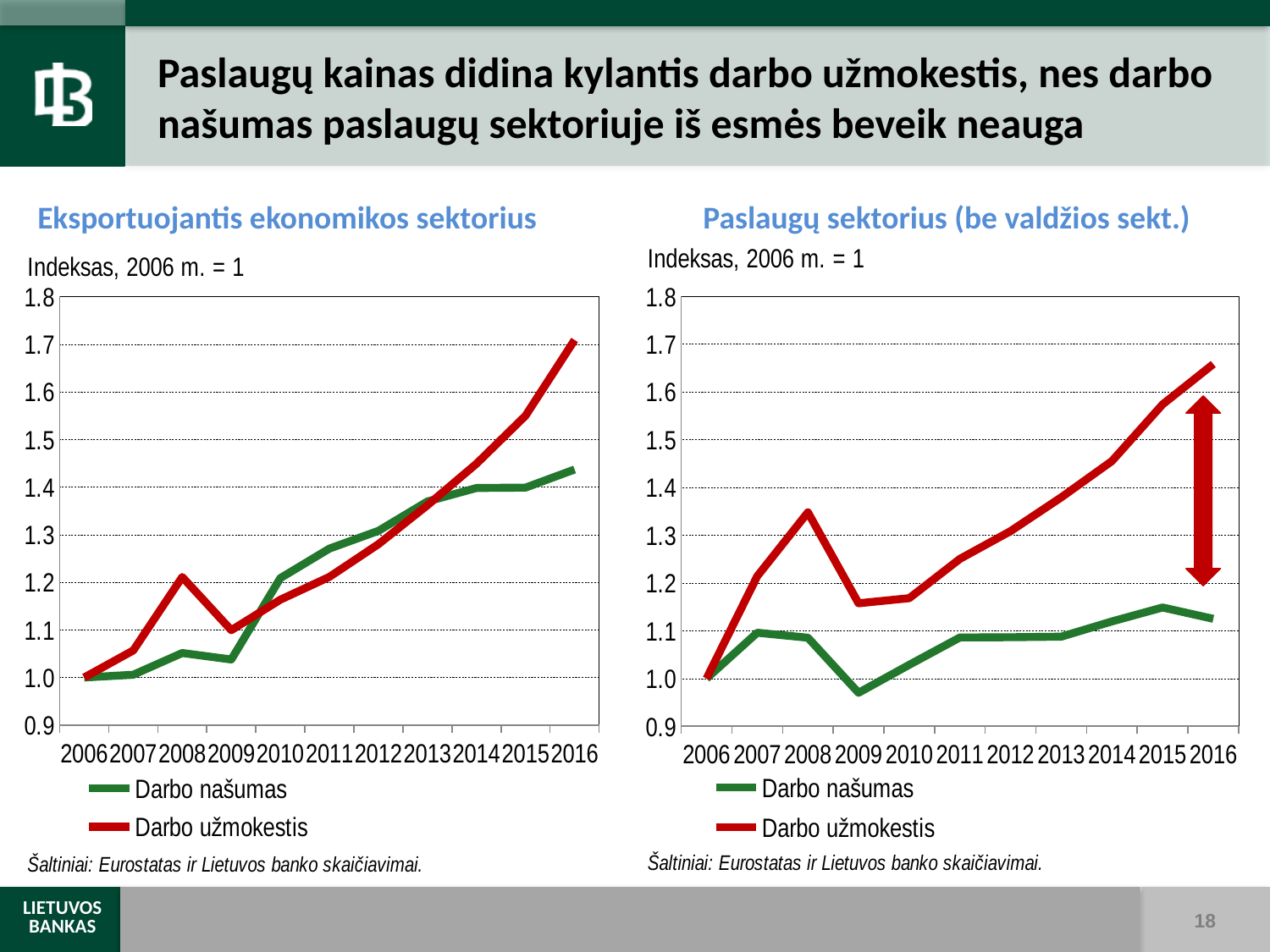
In the 'Eksportuojantis ekonomikos sektorius' chart, which series has the higher value in 2011, Darbo našumas or Darbo užmokestis? Darbo našumas How many series does the legend of the 'Paslaugų sektorius (be valdžios sekt.)' chart list? 2 In the 'Paslaugų sektorius (be valdžios sekt.)' chart, what is the value of Darbo našumas in 2006? 1.0 What colour is the Darbo užmokestis line in the 'Eksportuojantis ekonomikos sektorius' chart? red In the 'Paslaugų sektorius (be valdžios sekt.)' chart, is the value of Darbo našumas in 2016 greater or less than 1.2? less How many years are shown on the x axis of the 'Eksportuojantis ekonomikos sektorius' chart? 11 In the 'Paslaugų sektorius (be valdžios sekt.)' chart, which series has the higher value in 2016, Darbo našumas or Darbo užmokestis? Darbo užmokestis What type of chart is used for the 'Eksportuojantis ekonomikos sektorius' chart? line chart In the 'Eksportuojantis ekonomikos sektorius' chart, what is the value of Darbo užmokestis in 2006? 1.0 In the 'Paslaugų sektorius (be valdžios sekt.)' chart, does Darbo užmokestis rise or fall from 2009 to 2016? rise In the 'Eksportuojantis ekonomikos sektorius' chart, is the value of Darbo užmokestis in 2016 greater or less than 1.6? greater In the 'Paslaugų sektorius (be valdžios sekt.)' chart, is the value of Darbo našumas in 2009 greater or less than 1.0? less